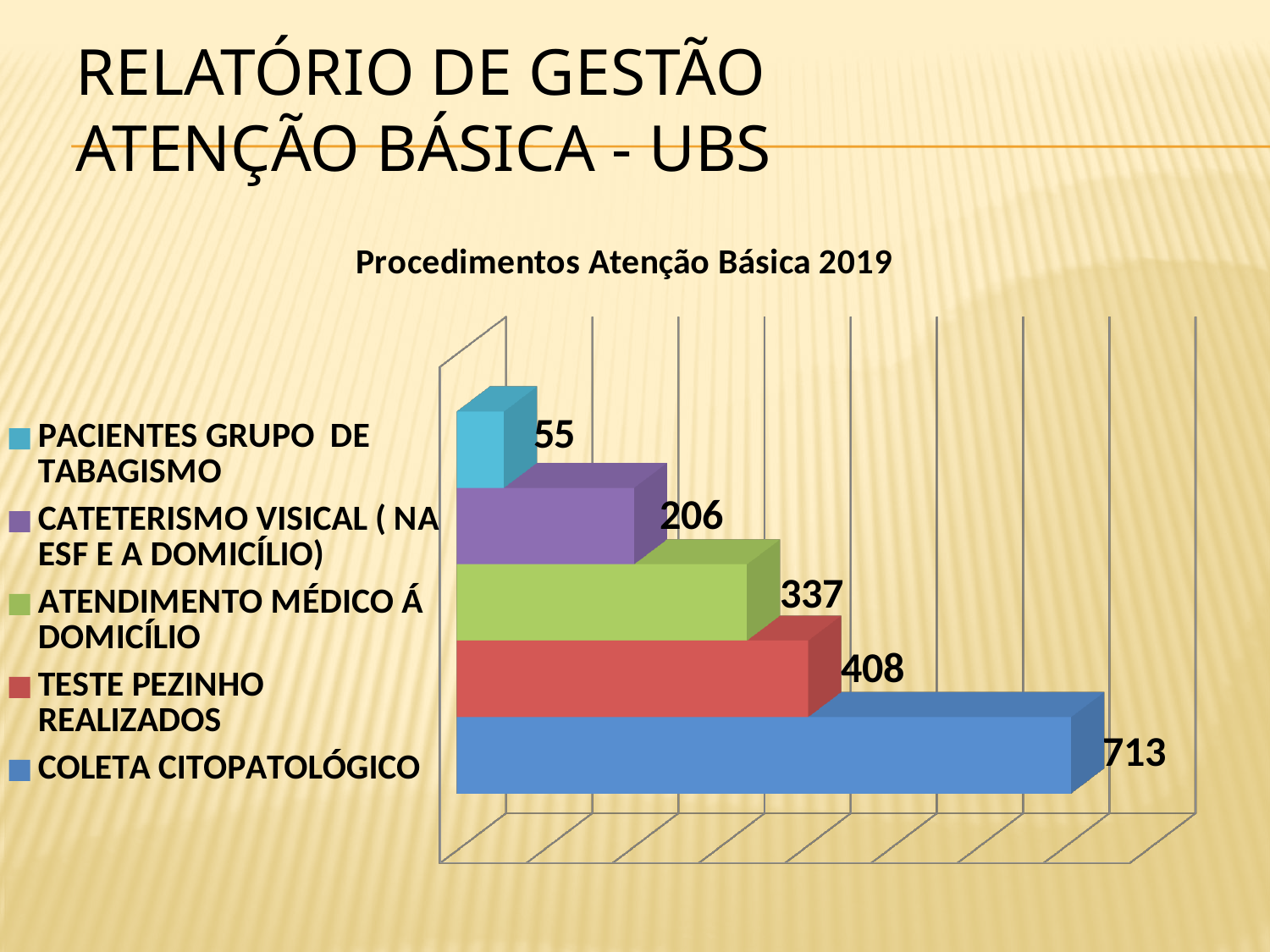
What is the value for COLETA CITOPATOLÓGICO? 713 Which category has the highest value? COLETA CITOPATOLÓGICO What is the value for ATENDIMENTO MÉDICO Á DOMICÍLIO? 337 What kind of chart is shown on the slide? Bar chart Which is larger, the value for TESTE PEZINHO REALIZADOS or the value for CATETERISMO VISICAL ( NA ESF E A DOMICÍLIO)? TESTE PEZINHO REALIZADOS What is the value for TESTE PEZINHO REALIZADOS? 408 What is the title of the chart? Procedimentos Atenção Básica 2019 What is the difference between the values for ATENDIMENTO MÉDICO Á DOMICÍLIO and CATETERISMO VISICAL ( NA ESF E A DOMICÍLIO)? 131 What is the value for PACIENTES GRUPO DE TABAGISMO? 55 What is the difference between the values for COLETA CITOPATOLÓGICO and TESTE PEZINHO REALIZADOS? 305 How many categories are shown in the chart? 5 Which category has the lowest value? PACIENTES GRUPO DE TABAGISMO